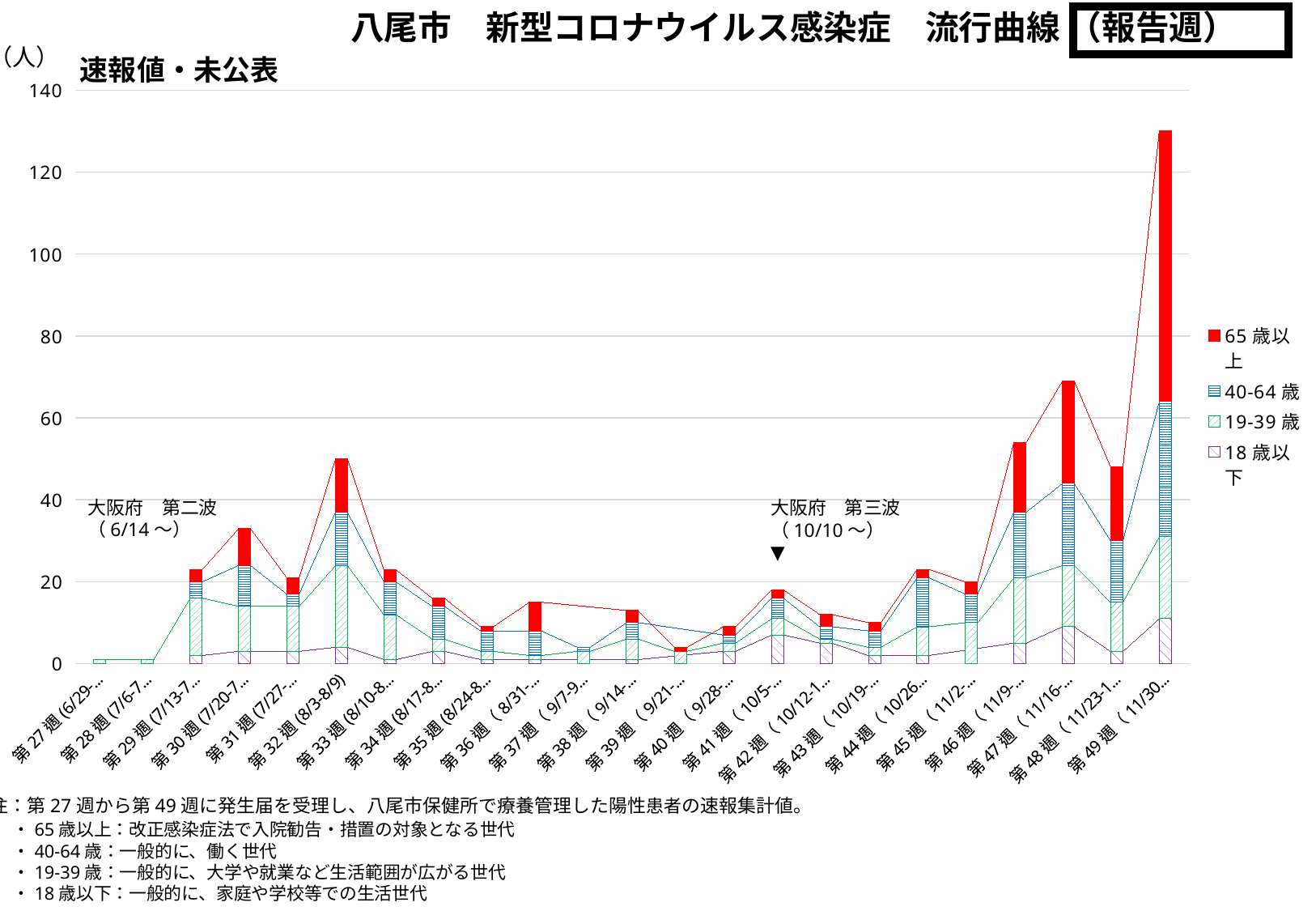
Which has the larger total, 第49週 or 第47週? 第49週 Which legend entry is shown in red? 65歳以上 How many series does the legend list? 4 Do the total values rise or fall from 第32週 to 第35週? fall How many weeks (categories) are plotted along the x axis? 23 Which week has the highest total number of cases? 第49週 What kind of chart is shown on the slide? bar chart Is the total value for 第49週 greater or less than 120? greater Is the total value for 第46週 greater or less than 40? greater Is the total value for 第35週 greater or less than 20? less Which has the larger total, 第32週 or 第33週? 第32週